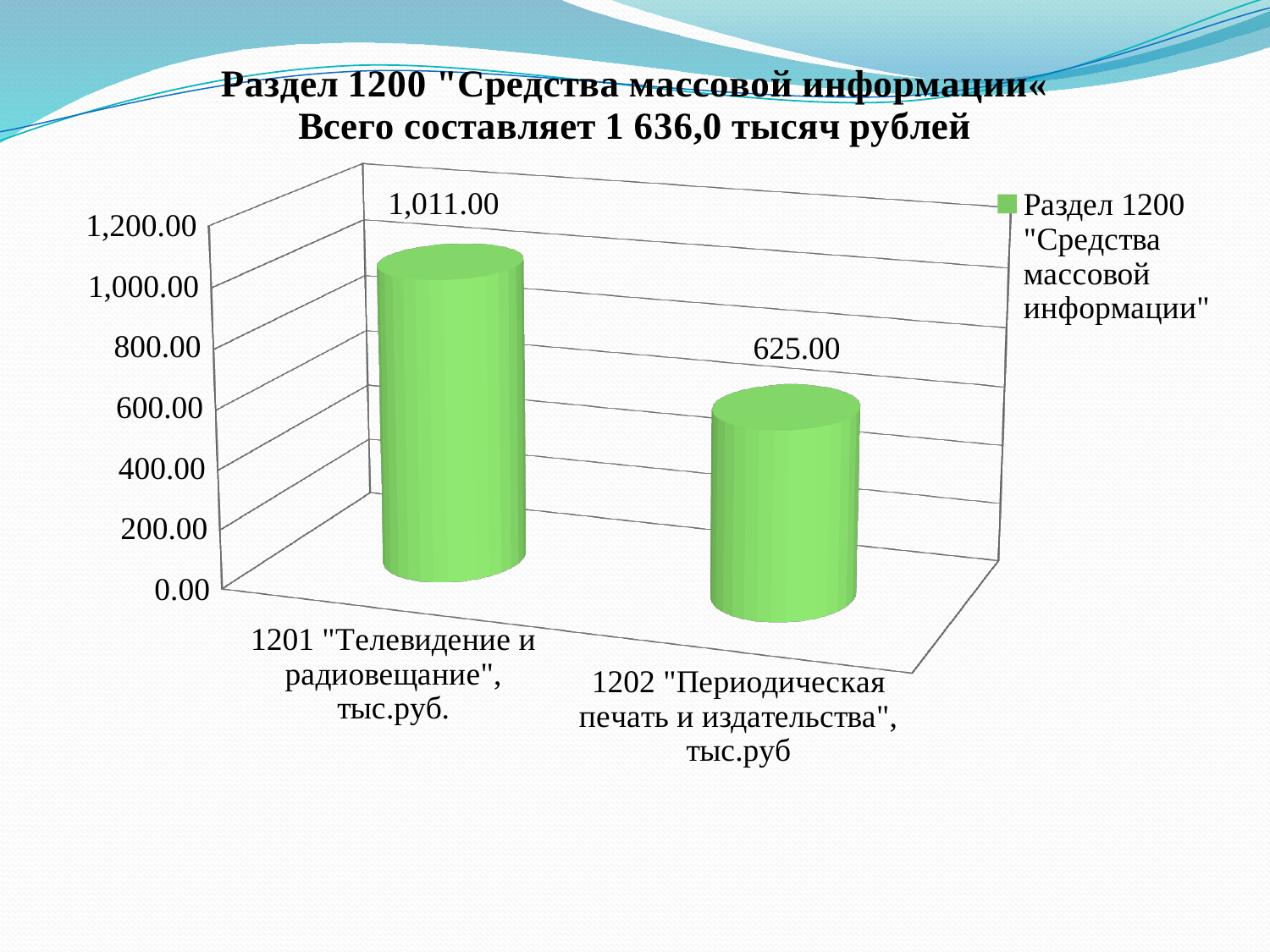
Which category has the highest value? 1201 "Телевидение и радиовещание" Which category has the lowest value? 1202 "Периодическая печать и издательства" Is the value for 1201 "Телевидение и радиовещание" greater or less than 1,000.00? greater How many series does the legend list? 1 How many categories are shown on the chart? 2 What is the value for 1202 "Периодическая печать и издательства"? 625.00 What kind of chart is shown on the slide? bar chart Which is larger: the value for 1201 "Телевидение и радиовещание" or for 1202 "Периодическая печать и издательства"? 1201 "Телевидение и радиовещание" What series name is shown in the legend? Раздел 1200 "Средства массовой информации" What is the difference between the values for 1201 "Телевидение и радиовещание" and 1202 "Периодическая печать и издательства"? 386.00 What is the value for 1201 "Телевидение и радиовещание"? 1,011.00 Is the value for 1202 "Периодическая печать и издательства" greater or less than 800.00? less